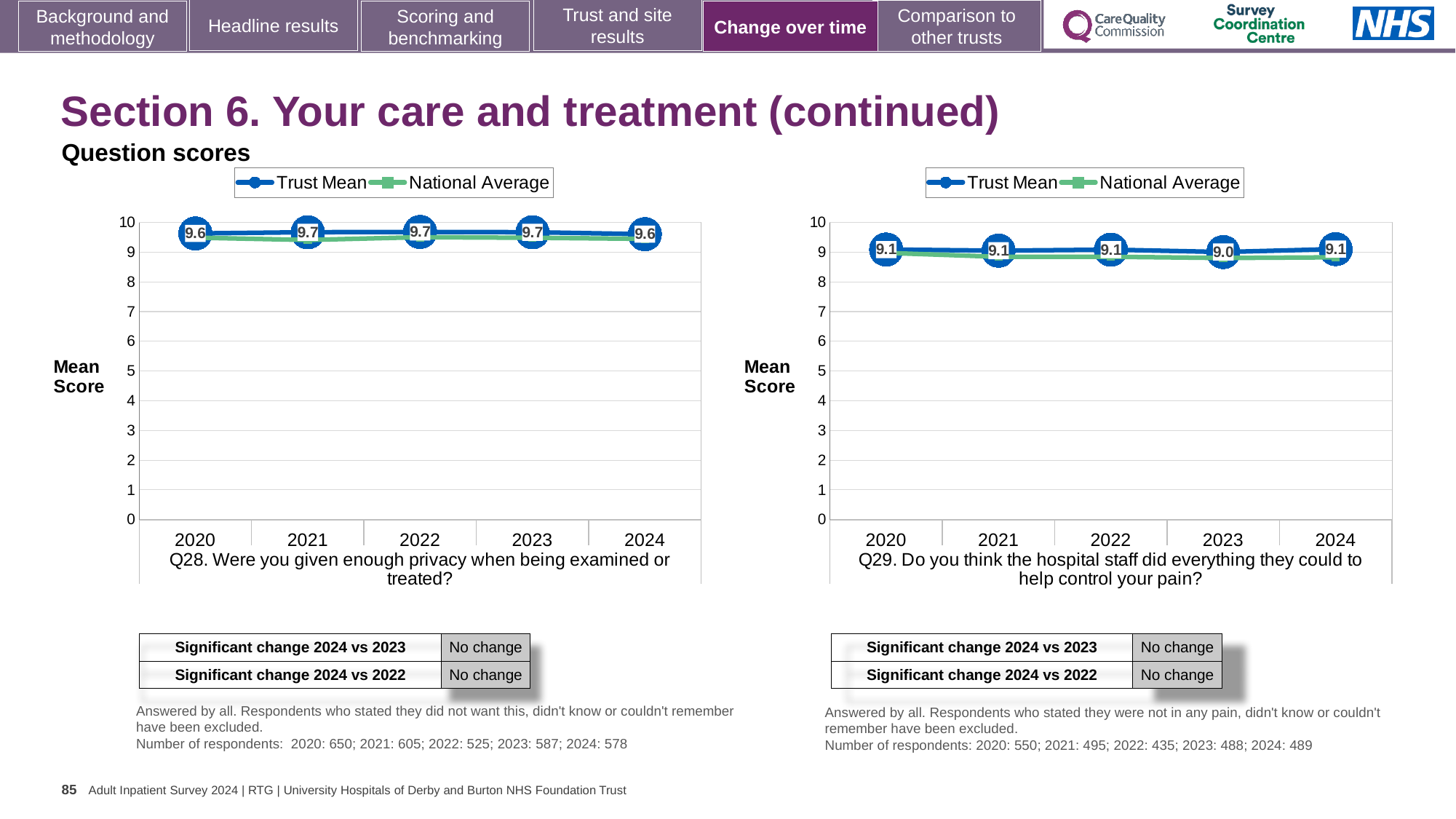
What is the label of the y axis on the Q28 chart on the left? Mean Score In the Q29 chart on the right, what is the Trust Mean score for 2020? 9.1 In the Q28 chart on the left, what is the Trust Mean score for 2024? 9.6 In the Q29 chart on the right, what is the Trust Mean score for 2023? 9.0 How many years are plotted on the x axis of the Q29 chart on the right? 5 What type of chart is the Q29 chart on the right? Line chart How many series does the legend of the Q28 chart on the left list? 2 In the Q29 chart on the right, which year has the lowest Trust Mean score? 2023 In the Q28 chart on the left, what is the Trust Mean score for 2022? 9.7 In the Q28 chart on the left, what is the difference between the Trust Mean scores for 2021 and 2024? 0.1 In the Q28 chart on the left, is the National Average value for 2020 greater or less than 9? greater In the Q28 chart on the left, is the Trust Mean score for 2021 larger or smaller than the score for 2024? larger